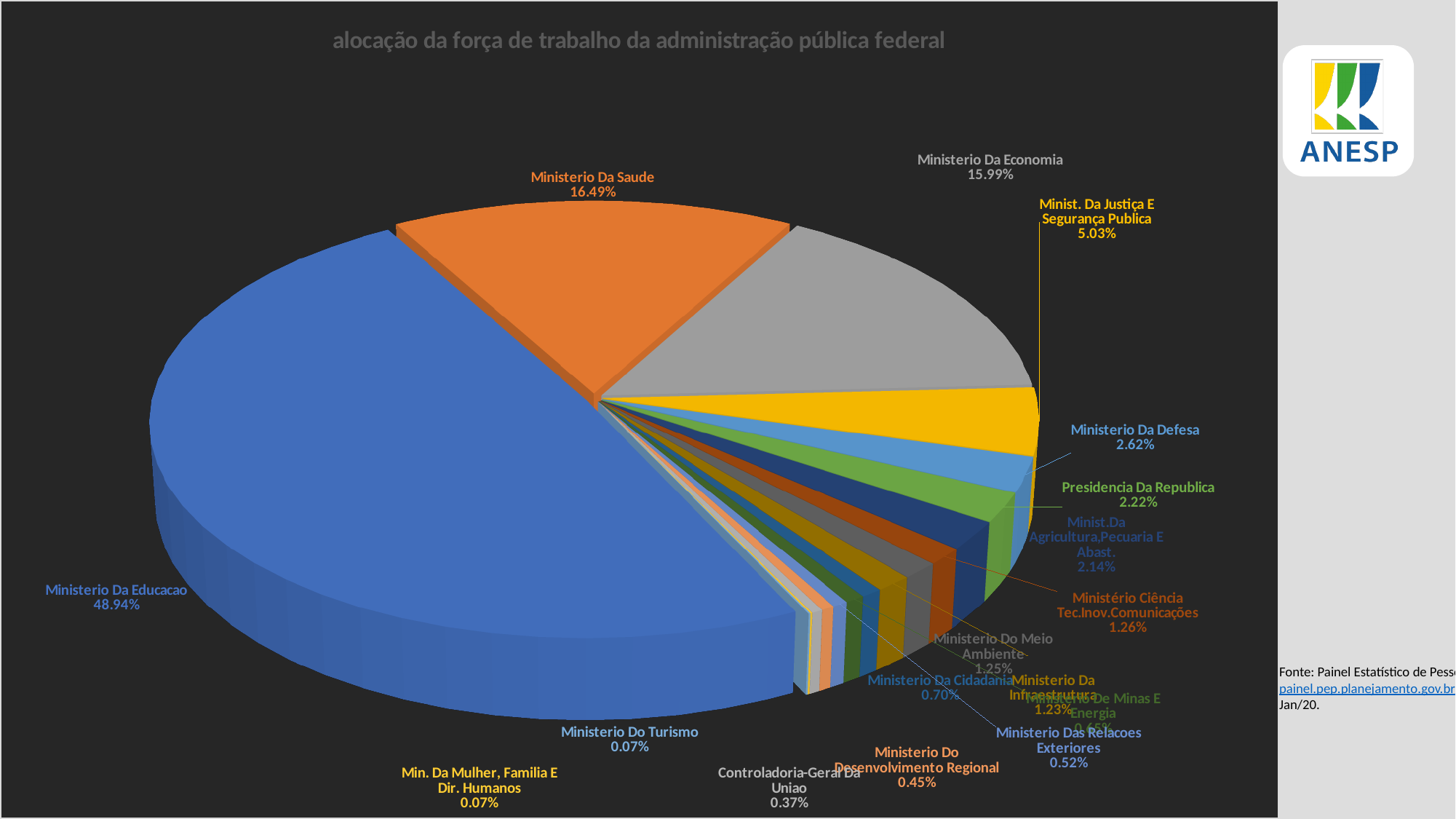
What is the title of the chart? alocação da força de trabalho da administração pública federal What is the value shown for Ministerio Da Saude? 16.49% Which is larger, the share for Presidencia Da Republica or the share for Ministerio Da Defesa? Ministerio Da Defesa Which category has the largest slice of the pie? Ministerio Da Educacao What is the value shown for Ministerio Das Relacoes Exteriores? 0.52% What is the value shown for Ministerio Da Economia? 15.99% What is the value shown for Ministerio Da Defesa? 2.62% What percentage is shown for Controladoria-Geral Da Uniao? 0.37% What kind of chart is shown on the slide? pie chart What percentage is shown for Minist. Da Justiça E Segurança Publica? 5.03% What share of the pie does Ministerio Da Educacao hold? 48.94% What is the difference between the values for Ministerio Da Saude and Ministerio Da Economia? 0.50%